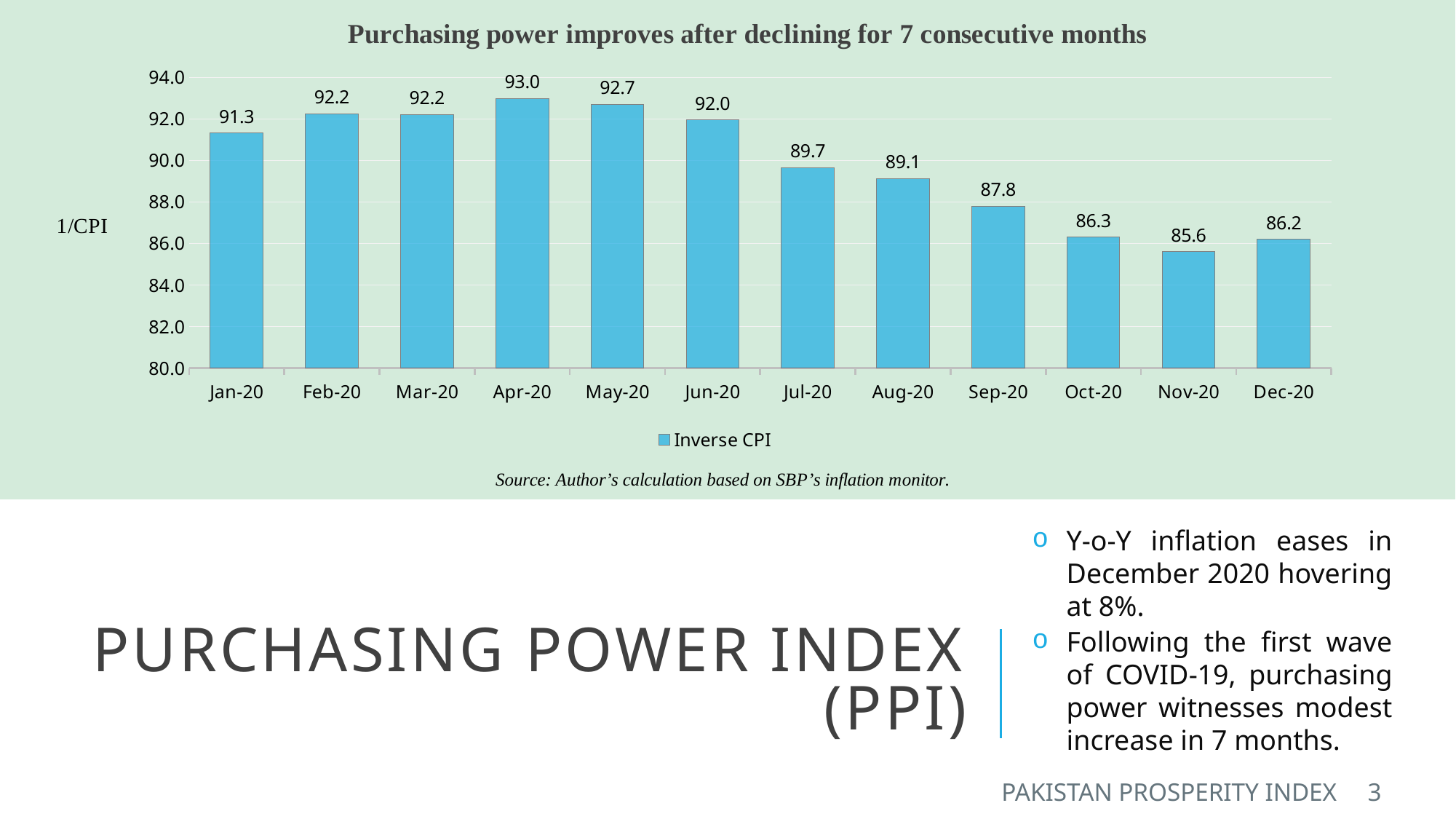
What is the difference between the Inverse CPI values for Jan-20 and Dec-20? 5.1 Which month has the lowest Inverse CPI value? Nov-20 What kind of chart is shown on the slide? bar chart Is the Inverse CPI value for Oct-20 greater or less than 88.0? less What is the Inverse CPI value for Sep-20? 87.8 What is the title of the chart? Purchasing power improves after declining for 7 consecutive months Which is larger, the Inverse CPI value for Jun-20 or for Jul-20? Jun-20 Which month has the highest Inverse CPI value? Apr-20 What is the Inverse CPI value for Apr-20? 93.0 What is the difference between the Inverse CPI values for Apr-20 and Nov-20? 7.4 How many months are shown on the x axis of the chart? 12 What is the Inverse CPI value for Nov-20? 85.6